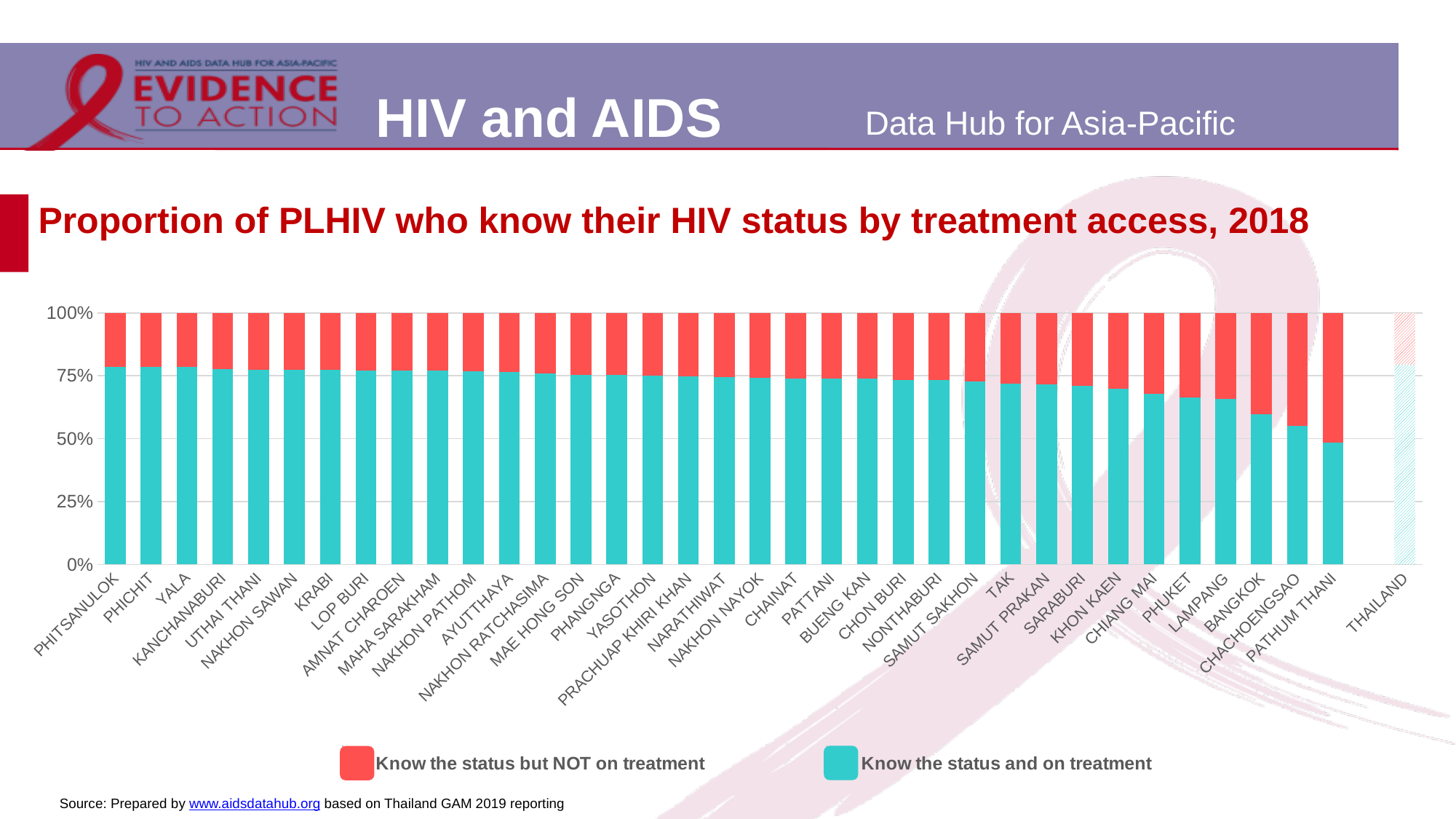
How many categories are shown along the x axis of the chart? 36 Is the value for 'Know the status and on treatment' for CHIANG MAI greater or less than 75%? less Is the value for 'Know the status and on treatment' for BANGKOK greater or less than 50%? greater What kind of chart is shown on the slide? Stacked bar chart What colour represents 'Know the status and on treatment' in the chart? Teal Which category has the lowest proportion of PLHIV who know their status and are on treatment? PATHUM THANI Does the 'Know the status and on treatment' share rise or fall moving from PHITSANULOK to PATHUM THANI along the x axis? Fall Which category has the largest share of PLHIV who know their status but are NOT on treatment? PATHUM THANI Is the value for 'Know the status and on treatment' for PATHUM THANI greater or less than 50%? less How many series does the legend list? 2 Which has a larger 'Know the status and on treatment' share, BANGKOK or PATHUM THANI? BANGKOK